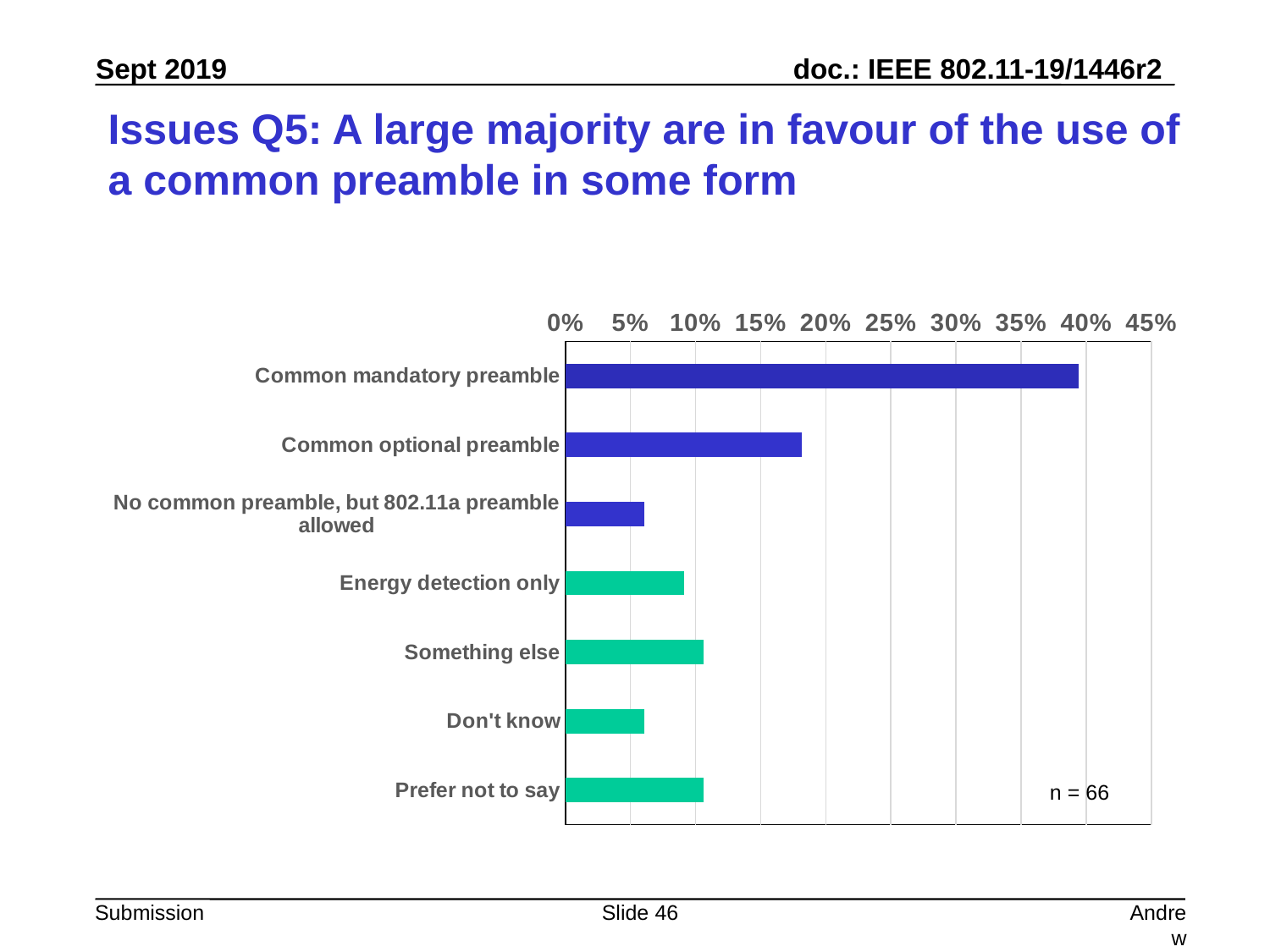
Is the value for Prefer not to say greater or less than 15%? less What sample size (n) is noted on the chart? n = 66 Which is larger, the value for Energy detection only or the value for Don't know? Energy detection only Which is larger, the value for Common mandatory preamble or the value for Common optional preamble? Common mandatory preamble Is the value for Common optional preamble greater or less than 15%? greater Which category has the highest value in the chart? Common mandatory preamble What kind of chart is shown on the slide? bar chart Is the value for Common optional preamble greater or less than 20%? less How many categories are plotted in the chart? 7